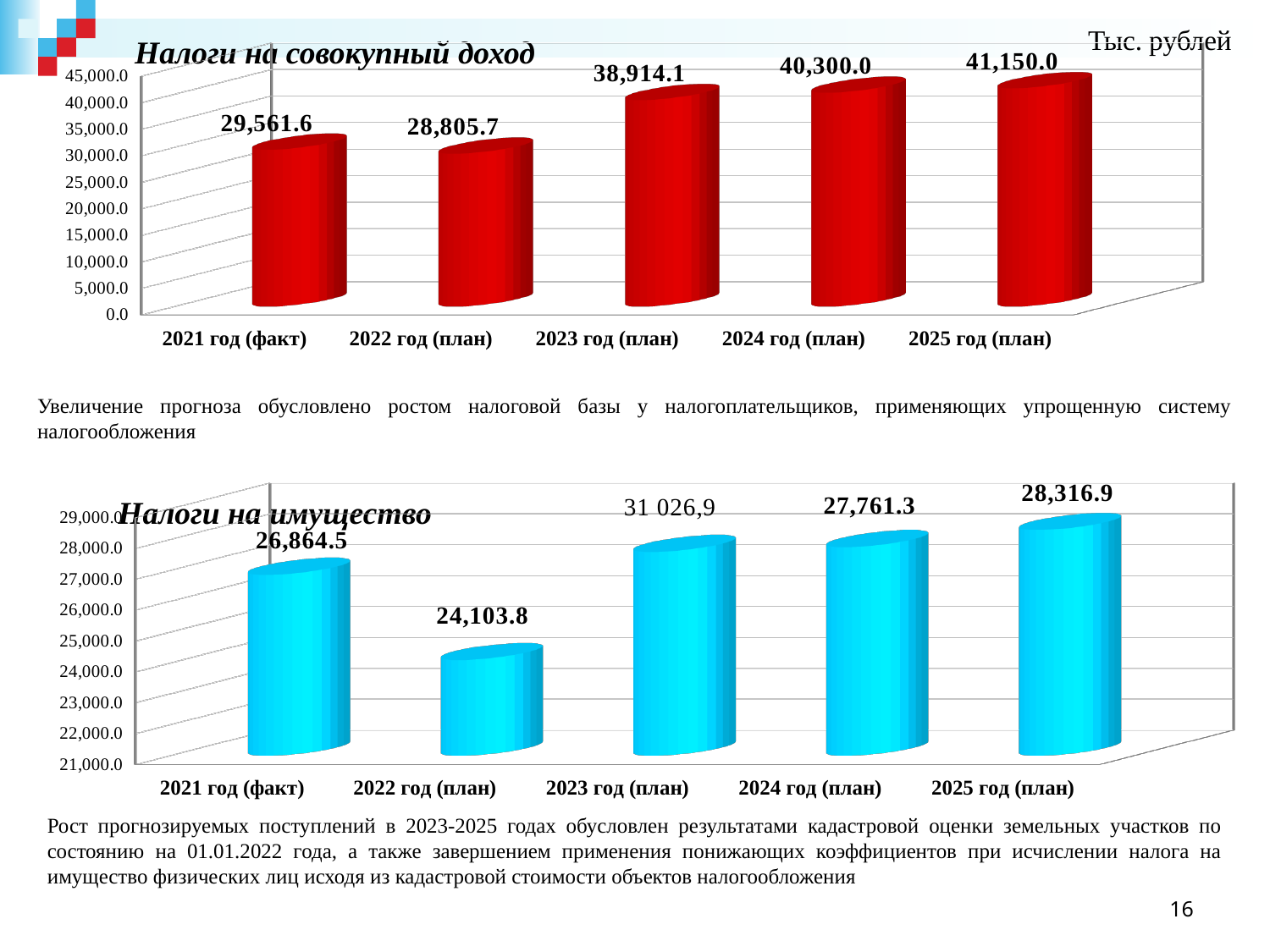
In the chart 'Налоги на совокупный доход', what is the value for 2021 год (факт)? 29,561.6 In the chart 'Налоги на имущество', what is the value for 2022 год (план)? 24,103.8 In the chart 'Налоги на совокупный доход', which year has the lowest value? 2022 год (план) In the chart 'Налоги на совокупный доход', which year has the highest value? 2025 год (план) In the chart 'Налоги на совокупный доход', what is the difference between the values for 2025 год (план) and 2021 год (факт)? 11,588.4 In the chart 'Налоги на имущество', what is the difference between the values for 2021 год (факт) and 2022 год (план)? 2,760.7 In the chart 'Налоги на имущество', which year has the lowest value? 2022 год (план) In the chart 'Налоги на совокупный доход', what is the value for 2025 год (план)? 41,150.0 In the chart 'Налоги на совокупный доход', is the value for 2023 год (план) greater or less than 35,000.0? greater In the chart 'Налоги на имущество', which is larger: the value for 2024 год (план) or 2025 год (план)? 2025 год (план) In the chart 'Налоги на имущество', what is the value for 2025 год (план)? 28,316.9 How many categories (years) are shown in the chart 'Налоги на совокупный доход'? 5